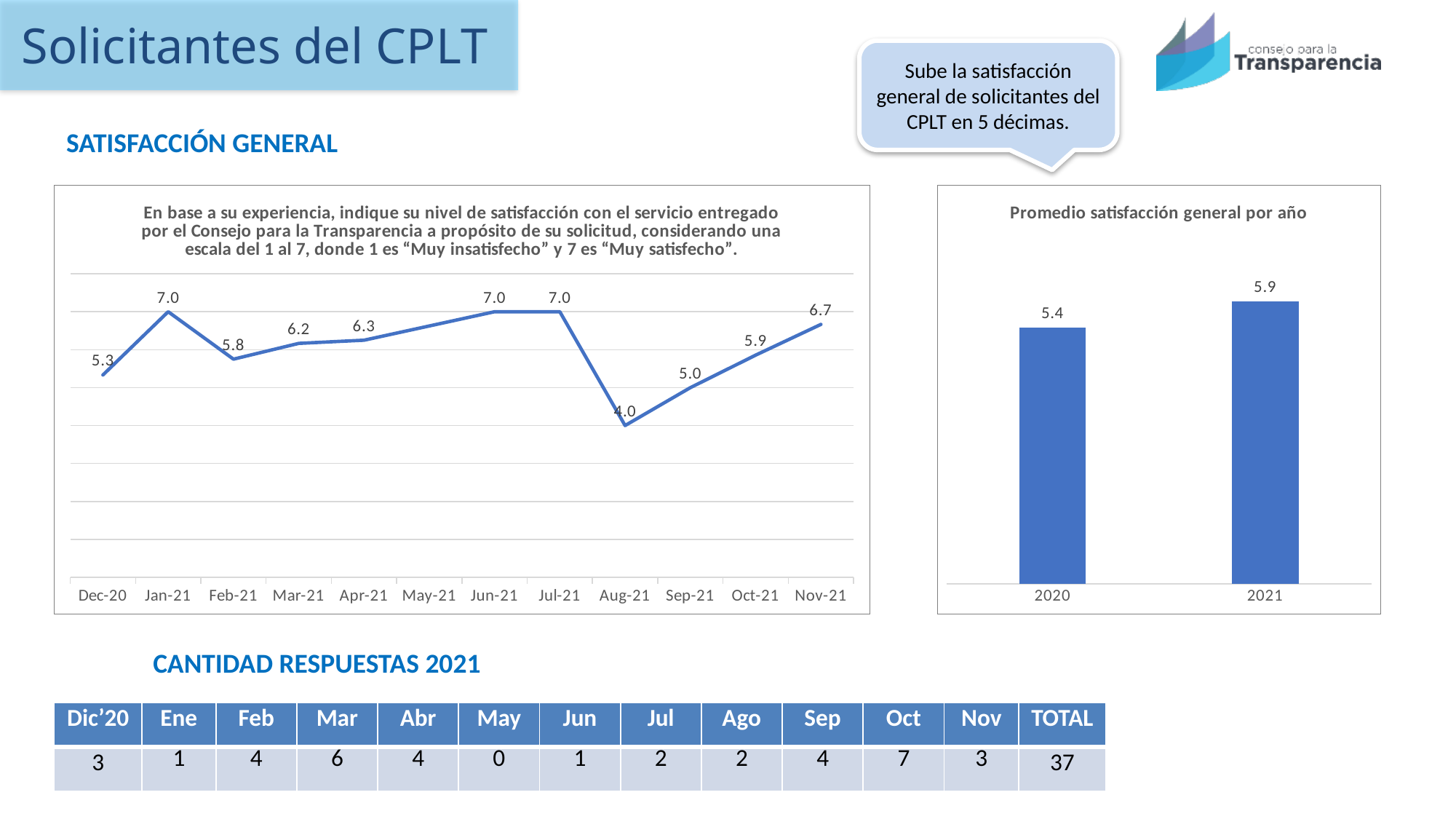
In the line chart on the left, which is larger, the value for Mar-21 or the value for Sep-21? Mar-21 In the line chart on the left, how many months are shown on the x axis? 12 In the line chart on the left, what is the value for Dec-20? 5.3 In the chart titled 'Promedio satisfacción general por año', which year has the higher value? 2021 In the line chart on the left, which month has the lowest value? Aug-21 What kind of chart is the chart titled 'Promedio satisfacción general por año'? bar chart In the line chart on the left, do the values rise or fall from Aug-21 to Nov-21? rise In the chart titled 'Promedio satisfacción general por año', what is the difference between 2021 and 2020? 0.5 In the line chart on the left, what is the value for Nov-21? 6.7 In the chart titled 'Promedio satisfacción general por año', what is the value for 2021? 5.9 In the line chart on the left, what is the difference between the values for Jul-21 and Aug-21? 3.0 In the line chart on the left, what is the value for Aug-21? 4.0